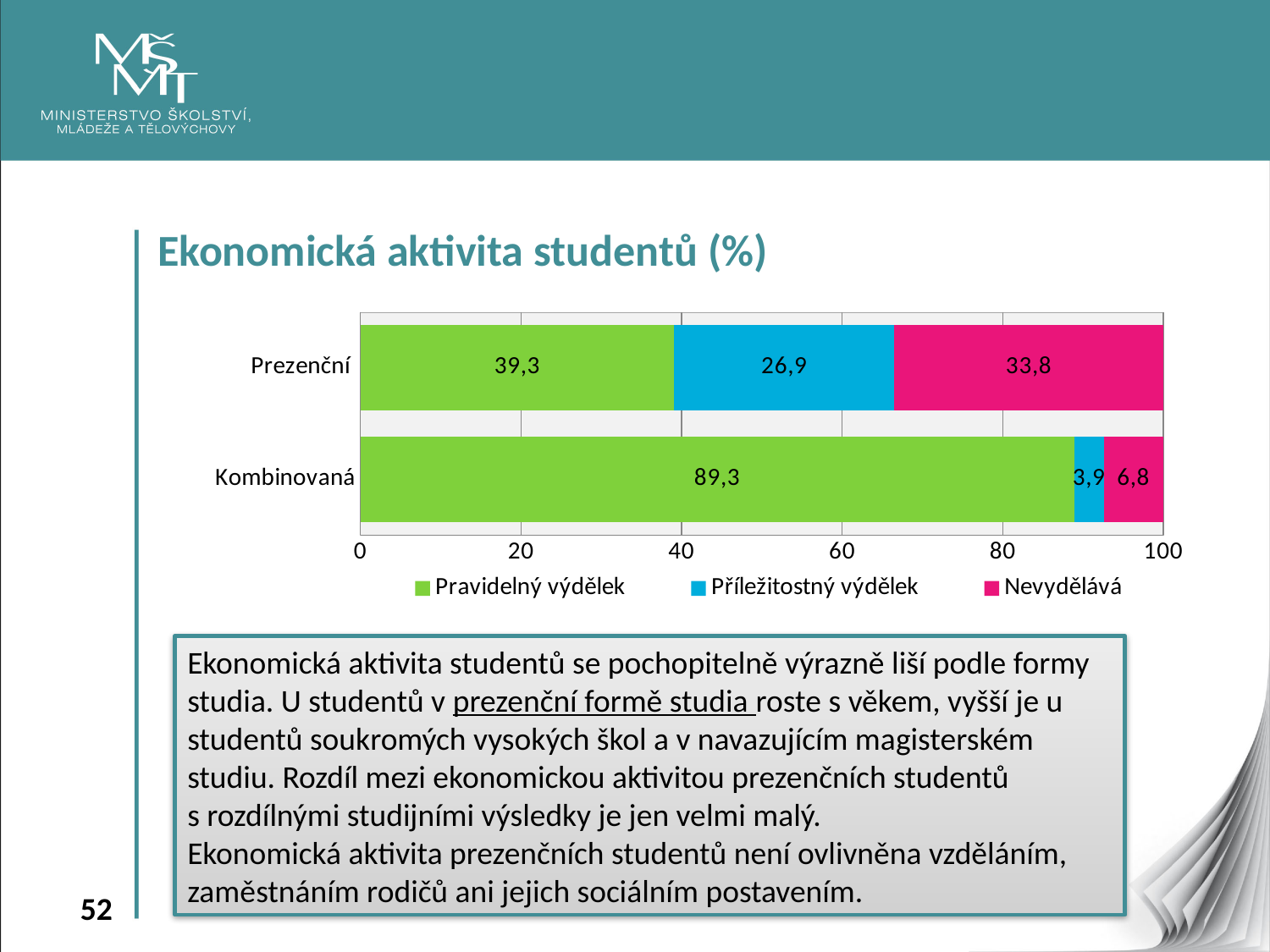
Which category has the higher value for Pravidelný výdělek, Prezenční or Kombinovaná? Kombinovaná What is the value of Nevydělává for Prezenční? 33,8 What is the difference between the Pravidelný výdělek values for Kombinovaná and Prezenční? 50,0 How many categories are shown on the chart? 2 What is the difference between the Nevydělává values for Prezenční and Kombinovaná? 27,0 Which category has the lowest value for Nevydělává? Kombinovaná What is the value of Příležitostný výdělek for Kombinovaná? 3,9 How many series does the legend list? 3 What is the value of Pravidelný výdělek for Kombinovaná? 89,3 What type of chart is shown on the slide? Stacked bar chart What is the value of Pravidelný výdělek for Prezenční? 39,3 What is the title of the chart? Ekonomická aktivita studentů (%)